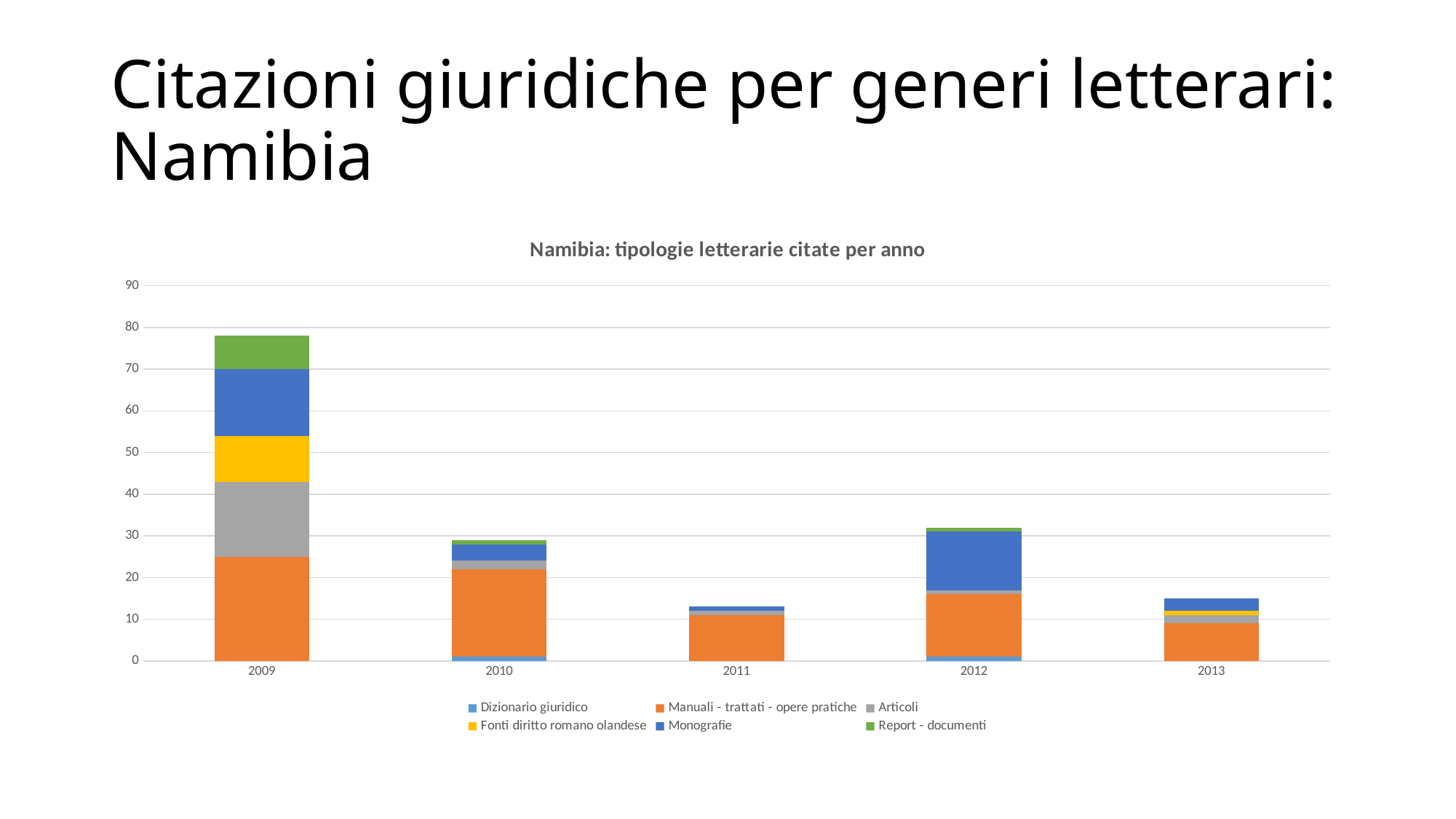
Is the total for 2010 greater or less than 40? less How many years are shown on the x axis of the chart? 5 Do the total bar heights rise or fall from 2009 to 2011? fall Which colour represents the Monografie series in the legend? Blue Is the total for 2011 greater or less than 20? less Is the total for 2009 greater or less than 70? greater How many series does the legend list? 6 Which year has the highest total stacked bar? 2009 Which is larger, the total bar for 2009 or the total bar for 2012? 2009 What is the title of the chart? Namibia: tipologie letterarie citate per anno What kind of chart is shown on the slide? Stacked bar chart